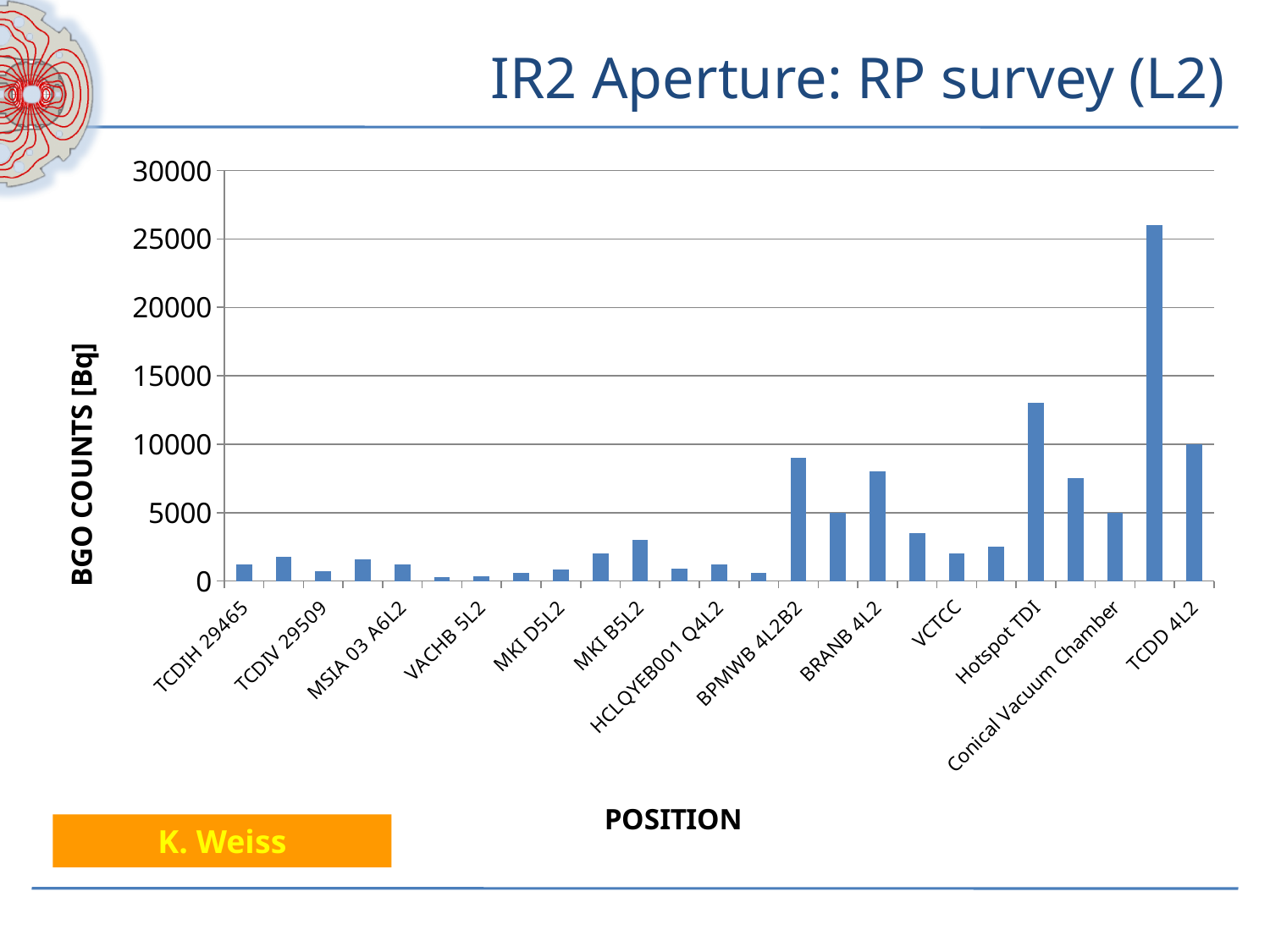
Which has the larger value, Hotspot TDI or TCDD 4L2? Hotspot TDI Which has the larger value, BPMWB 4L2B2 or TCDIH 29465? BPMWB 4L2B2 Is the value for BRANB 4L2 greater or less than 5000? greater Which has the larger value, BRANB 4L2 or VCTCC? BRANB 4L2 Is the value for BPMWB 4L2B2 greater or less than 10000? less Is the value for Hotspot TDI greater or less than 15000? less What is the label of the vertical axis of the chart? BGO COUNTS [Bq] What is the title of the chart on the slide? IR2 Aperture: RP survey (L2) What kind of chart is shown on the slide? bar chart